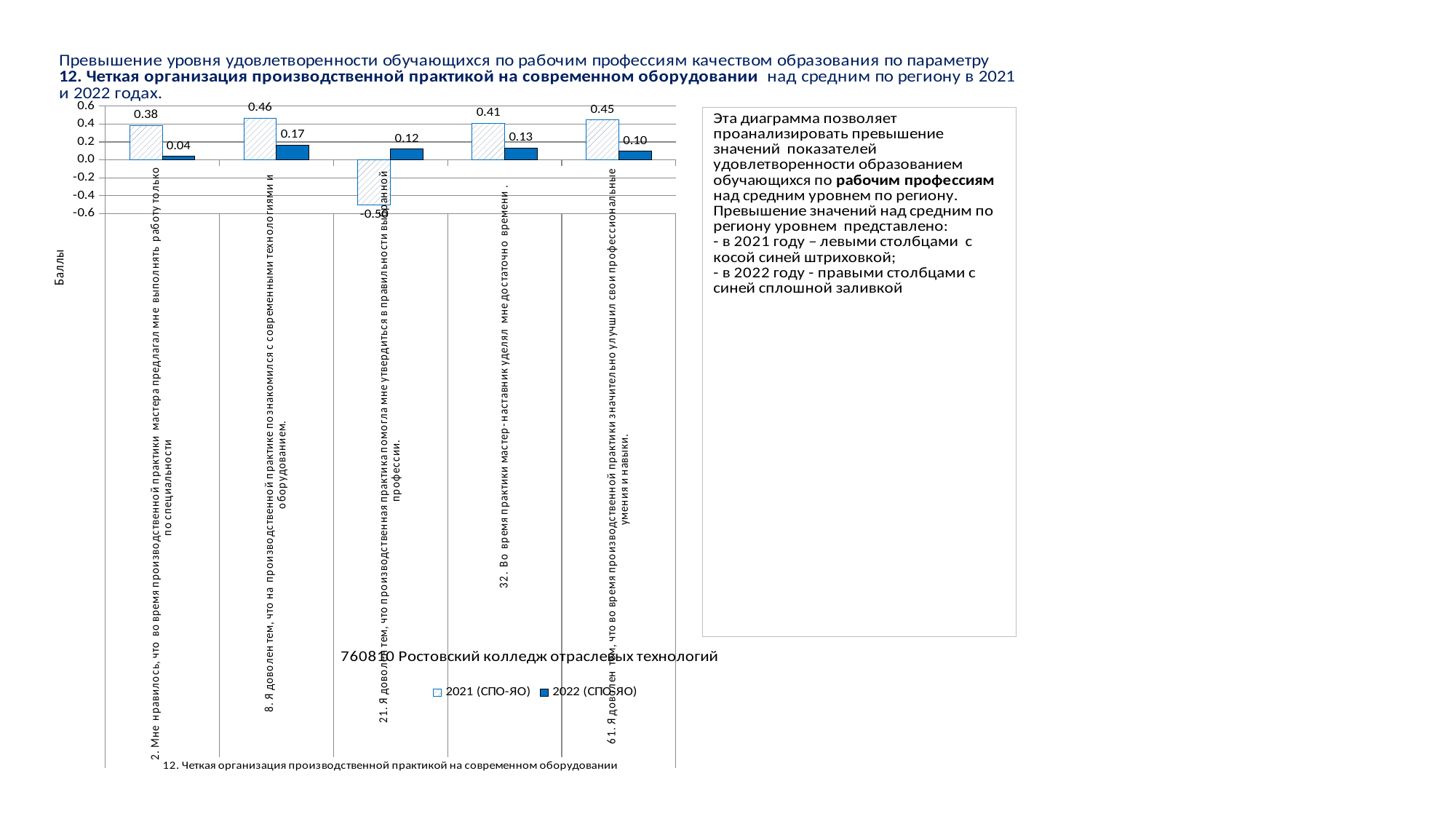
What is the 2022 (СПО-ЯО) value for question 61 ("Я доволен тем, что во время производственной практики значительно улучшил свои профессиональные умения и навыки")? 0.10 Which is larger: the 2021 (СПО-ЯО) value for question 8 or the 2021 (СПО-ЯО) value for question 61? Question 8 (0.46) How many series does the chart legend list? 2 Which question has the highest 2021 (СПО-ЯО) value? 8. Я доволен тем, что на производственной практике познакомился с современными технологиями и оборудованием (0.46) What are the two series named in the chart legend? 2021 (СПО-ЯО) and 2022 (СПО-ЯО) Which question has the lowest 2022 (СПО-ЯО) value? 2. Мне нравилось, что во время производственной практики мастер предлагал мне выполнять работу только по специальности (0.04) What type of chart is shown on the slide? Bar chart How many questions (categories) are shown on the x axis of the chart? 5 What is the 2022 (СПО-ЯО) value for question 8 ("Я доволен тем, что на производственной практике познакомился с современными технологиями и оборудованием")? 0.17 For question 32, what is the difference between the 2021 (СПО-ЯО) value and the 2022 (СПО-ЯО) value? 0.28 Is the 2021 (СПО-ЯО) value for question 21 greater or less than -0.4? less What is the 2021 (СПО-ЯО) value for question 2 ("Мне нравилось, что во время производственной практики мастер предлагал мне выполнять работу только по специальности")? 0.38